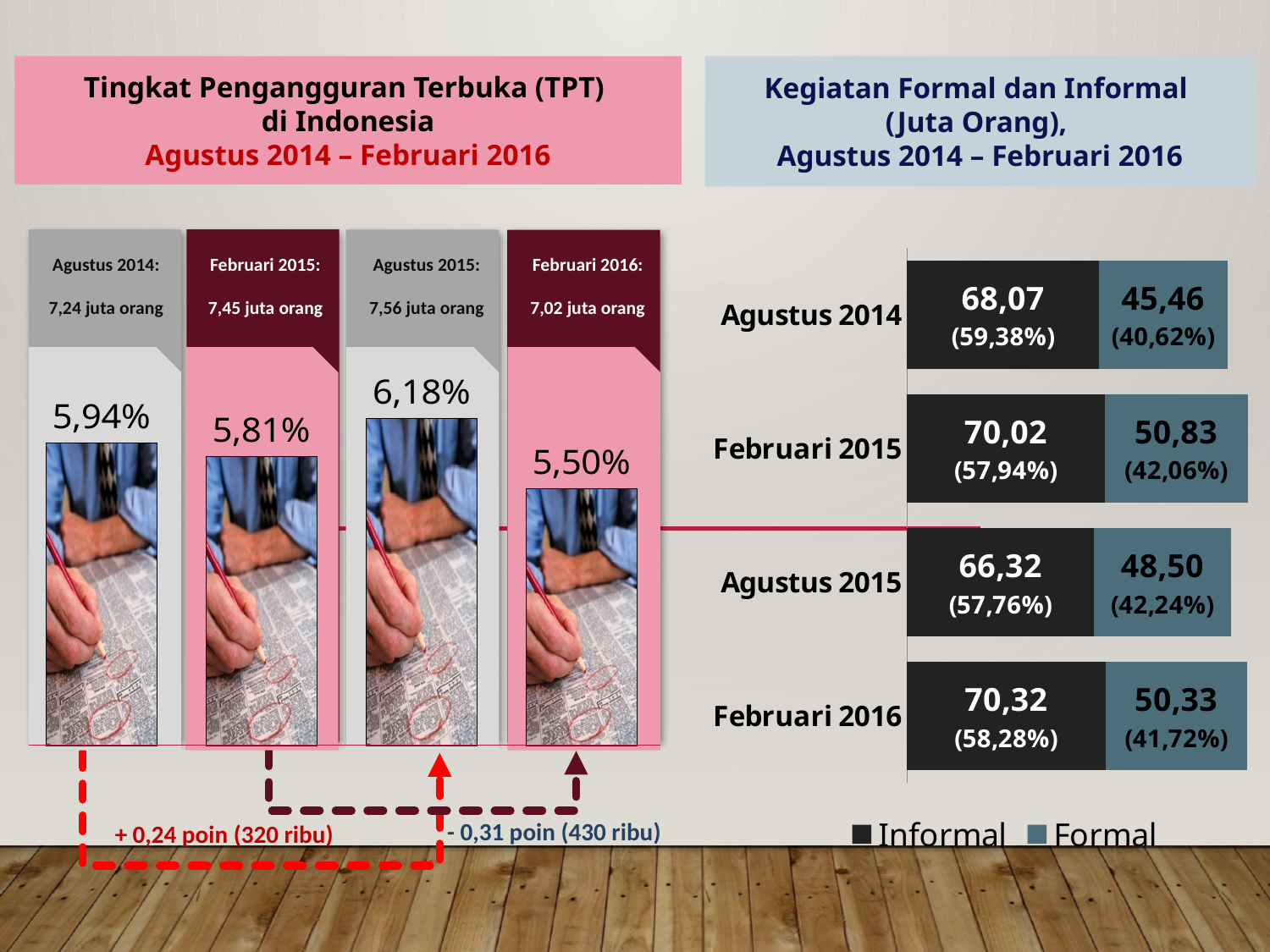
In the chart 'Tingkat Pengangguran Terbuka (TPT) di Indonesia', how many juta orang are shown for Februari 2015? 7,45 juta orang In the chart 'Kegiatan Formal dan Informal (Juta Orang)', what is the Informal value for Agustus 2014? 68,07 In the chart 'Kegiatan Formal dan Informal (Juta Orang)', which period has the highest Informal value? Februari 2016 In the chart 'Tingkat Pengangguran Terbuka (TPT) di Indonesia', what is the TPT value for Agustus 2015? 6,18% In the chart 'Kegiatan Formal dan Informal (Juta Orang)', what is the difference between the Informal and Formal values for Agustus 2015? 17,82 In the chart 'Kegiatan Formal dan Informal (Juta Orang)', what kind of chart is used? Stacked bar chart In the chart 'Tingkat Pengangguran Terbuka (TPT) di Indonesia', how many periods are shown? 4 In the chart 'Kegiatan Formal dan Informal (Juta Orang)', how many series does the legend list? 2 In the chart 'Kegiatan Formal dan Informal (Juta Orang)', what is the Formal value for Februari 2016? 50,33 In the chart 'Tingkat Pengangguran Terbuka (TPT) di Indonesia', which period has the lowest TPT? Februari 2016 In the chart 'Kegiatan Formal dan Informal (Juta Orang)', which period has the lowest Formal value? Agustus 2014 In the chart 'Kegiatan Formal dan Informal (Juta Orang)', what percentage share is shown for Formal in Februari 2015? (42,06%)